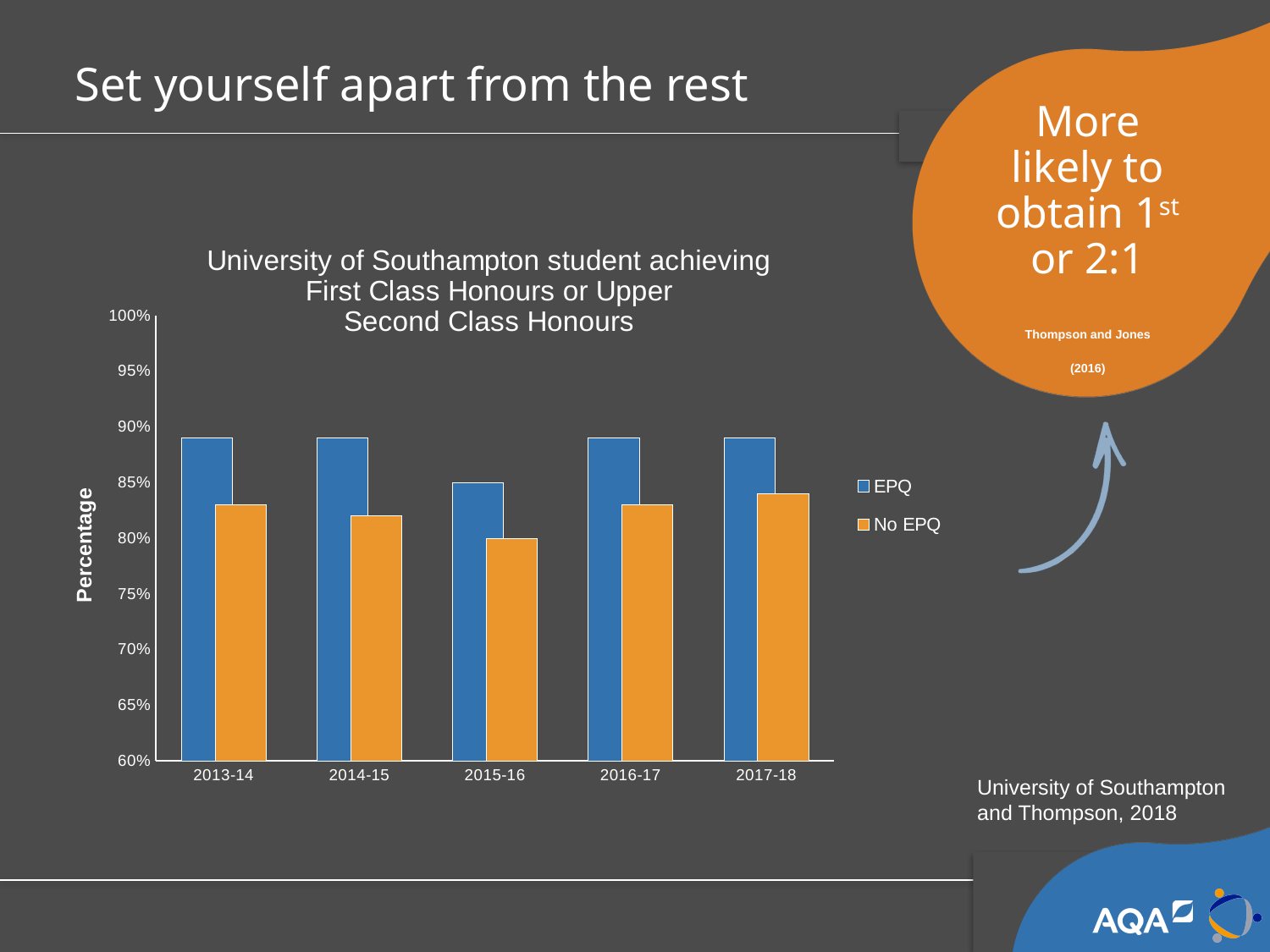
How many academic years are shown on the x axis? 5 How many series does the legend list? 2 Which year has the lowest EPQ value? 2015-16 Which year has the lowest No EPQ value? 2015-16 What is the label on the y axis of the chart? Percentage Which is larger, the No EPQ value for 2017-18 or for 2015-16? 2017-18 Do the No EPQ values rise or fall from 2015-16 to 2017-18? rise Is the No EPQ value for 2015-16 greater or less than 85%? less Is the EPQ value for 2013-14 greater or less than 85%? greater In 2015-16, which is larger, the EPQ value or the No EPQ value? EPQ Is the EPQ value for 2017-18 greater or less than 90%? less What kind of chart is shown on the slide? bar chart